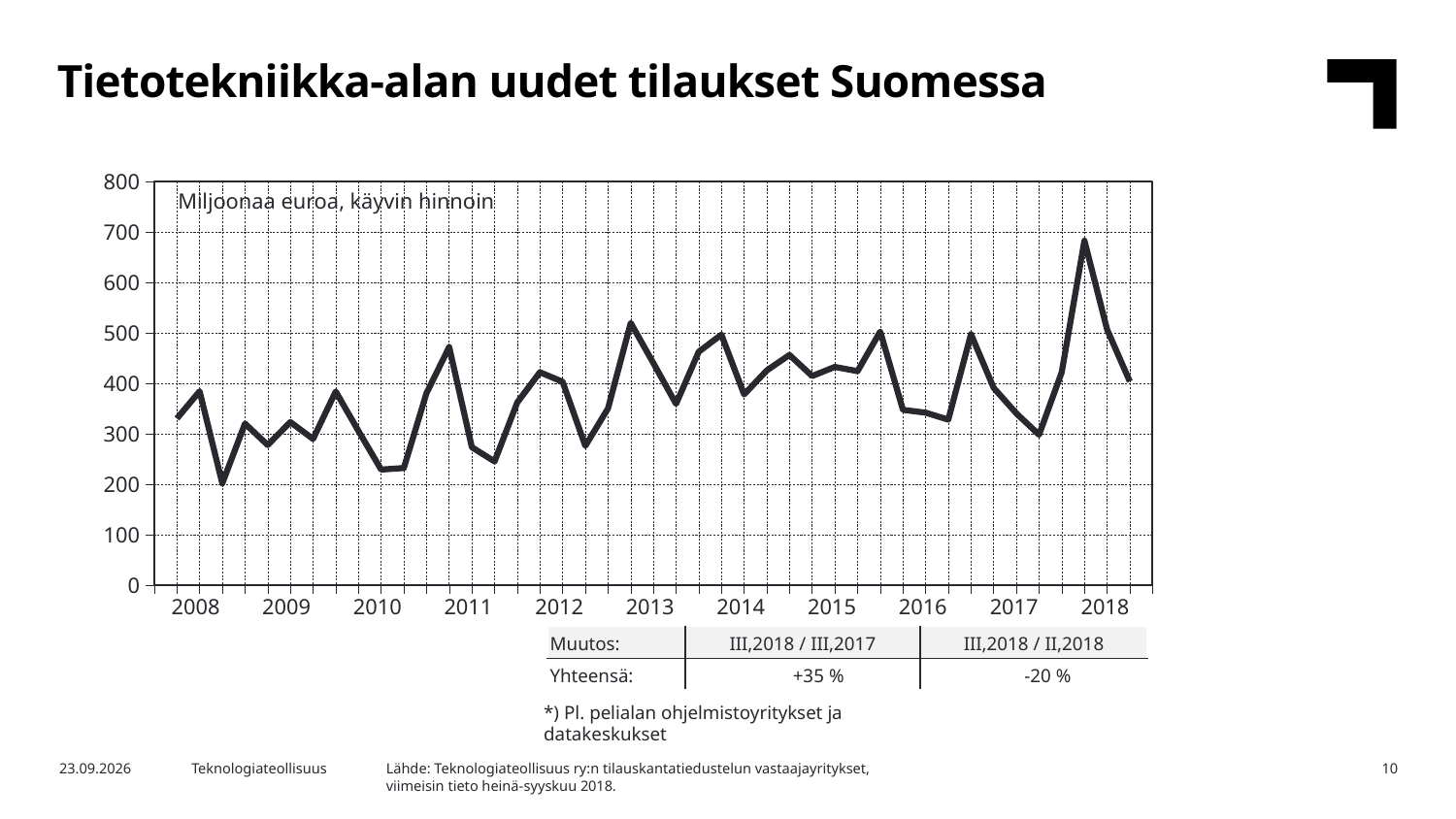
What is the title of the chart? Tietotekniikka-alan uudet tilaukset Suomessa According to the table below the chart, what is the change III,2018 / II,2018 for Yhteensä? -20 % What unit label is printed inside the chart area? Miljoonaa euroa, käyvin hinnoin What kind of chart is shown on the slide? line chart Is the lowest point of the line in 2010 greater or less than 300? less Which peak is higher, the one in 2013 or the one in 2018? 2018 In which year does the line reach its highest value? 2018 Is the lowest point of the line in 2008 greater or less than 300? less Is the highest point of the line greater or less than 600? greater After the peak in 2018, does the line rise or fall towards the last point? fall According to the table below the chart, what is the change III,2018 / III,2017 for Yhteensä? +35 %